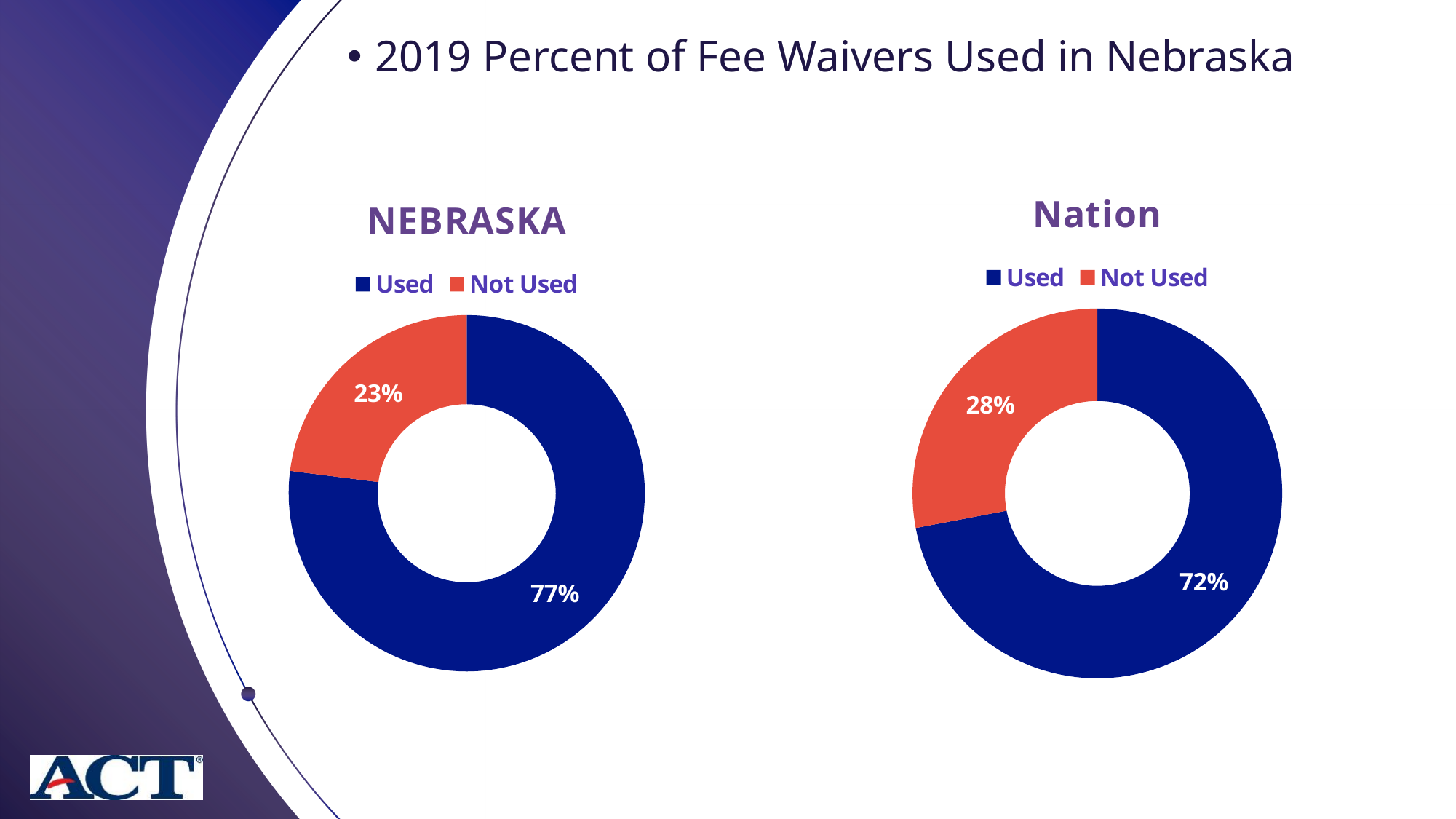
What type of chart is the NEBRASKA chart? Doughnut (pie) chart What is the difference between the Used percentage in the NEBRASKA chart and the Used percentage in the Nation chart? 5% In the Nation chart, what percentage of fee waivers were Not Used? 28% How many categories does the Nation chart show? 2 What is the title of the chart on the right side of the slide? Nation In the NEBRASKA chart, what percentage of fee waivers were Used? 77% In the Nation chart, what percentage of fee waivers were Used? 72% In the Nation chart, which category has the smallest share? Not Used Is the Not Used share larger in the NEBRASKA chart or the Nation chart? Nation In the NEBRASKA chart, what percentage of fee waivers were Not Used? 23% In the NEBRASKA chart, which category has the largest share? Used In the NEBRASKA chart, what colour represents the Not Used category? Red